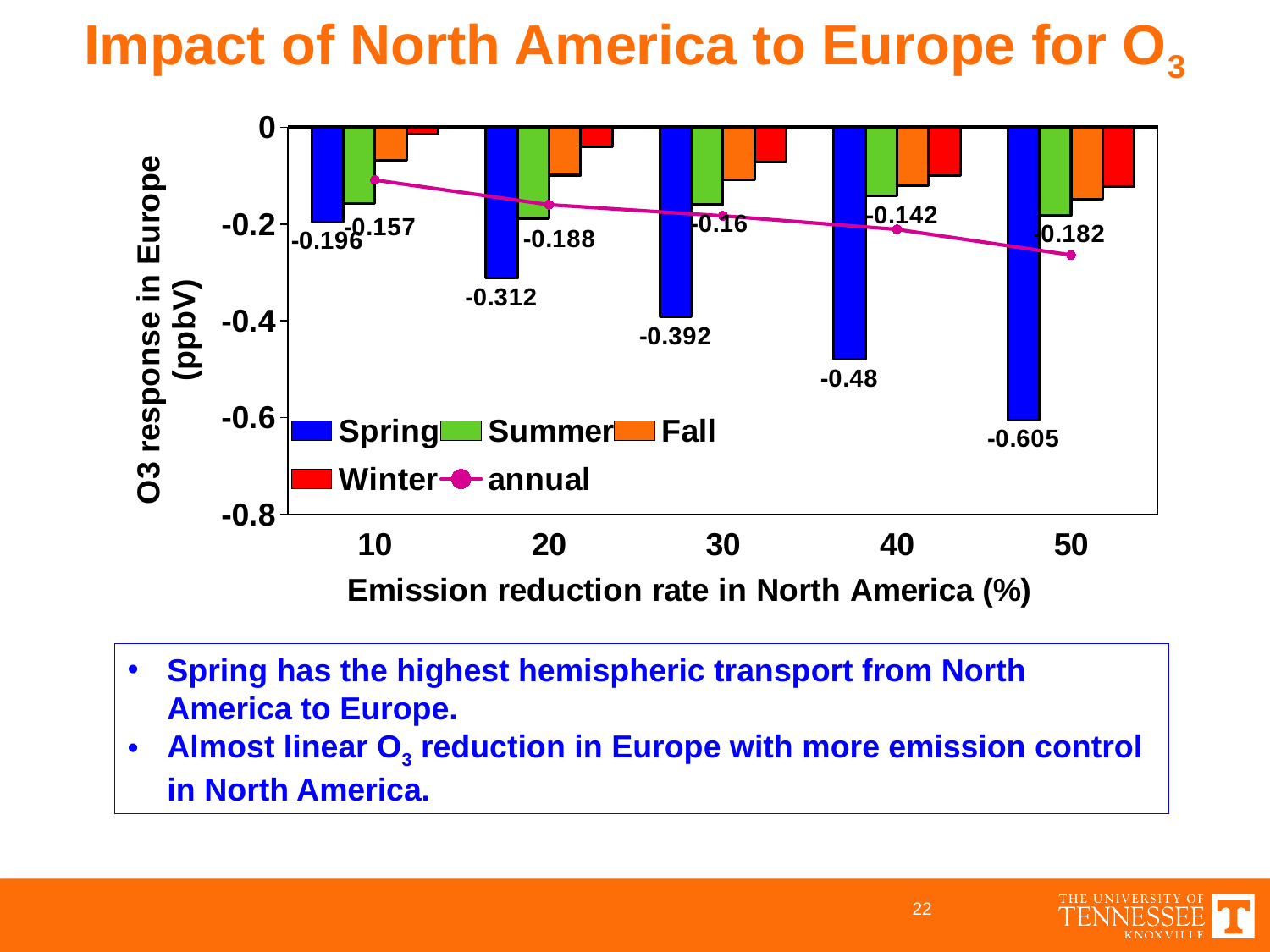
What is the Summer O3 response at a 20% emission reduction rate? -0.188 How many emission reduction rate categories are shown on the x axis? 5 What is the Spring O3 response at a 30% emission reduction rate? -0.392 By how much does the Spring O3 response at 50% differ from the Spring response at 10%? 0.409 What is the Spring O3 response at a 50% emission reduction rate? -0.605 What kind of chart is shown on the slide? Bar chart with a line series At which emission reduction rate is the Spring O3 response most negative? 50 Is the annual O3 response at a 50% emission reduction rate greater or less than -0.2? less How does the Spring O3 response change as the emission reduction rate increases from 10% to 50%? It becomes more negative (decreases) How many series does the legend list? 5 At which emission reduction rate is the Summer O3 response least negative? 40 What is the Spring O3 response at a 10% emission reduction rate? -0.196